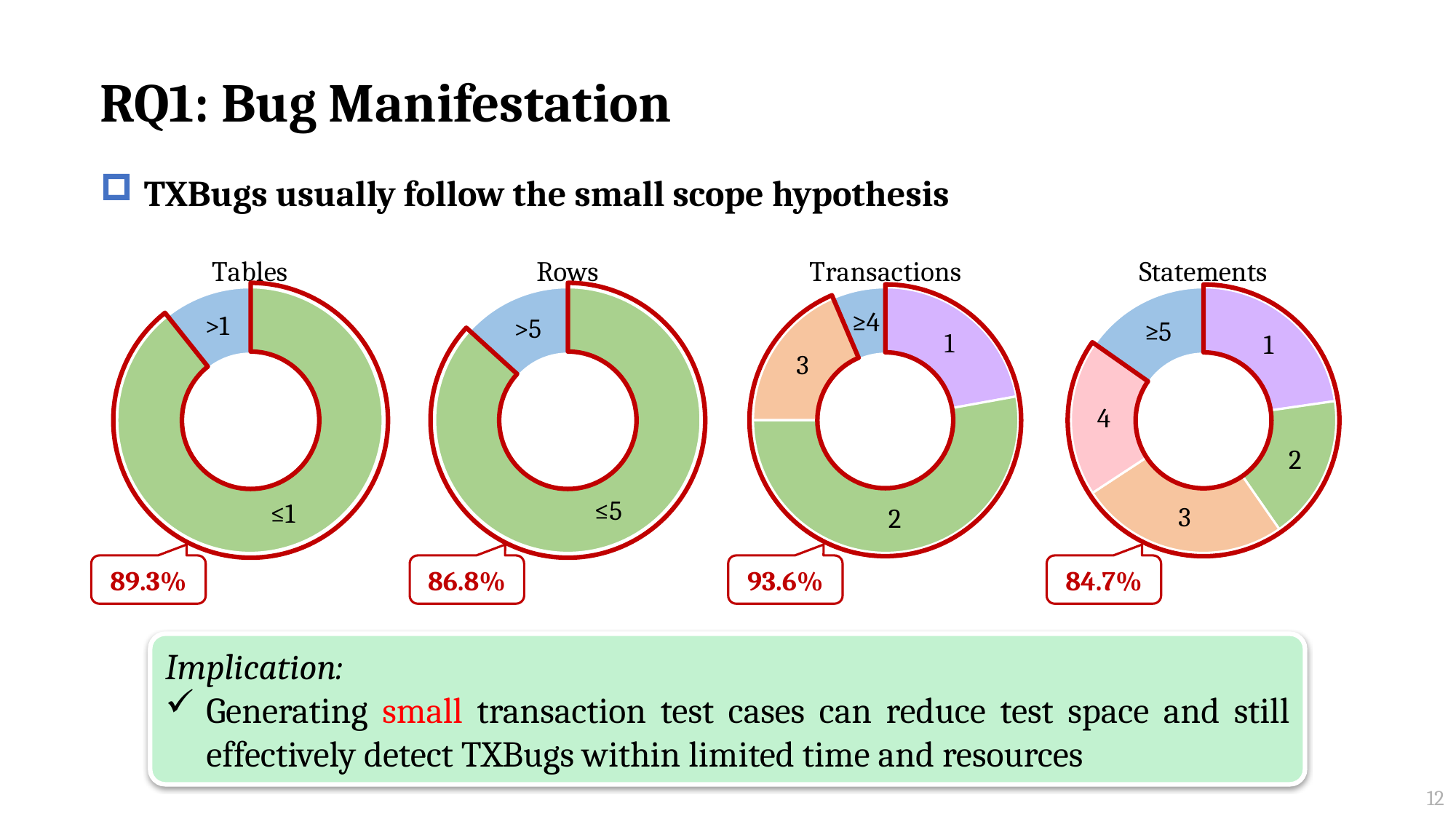
In the "Transactions" chart, which slice is the largest? 2 Which of the four charts has the highest callout percentage? Transactions In the "Tables" chart, which slice is the largest? ≤1 In the "Rows" chart, what percentage is shown in the callout for the ≤5 slice? 86.8% In the "Transactions" chart, what percentage is shown in the callout? 93.6% How many slices does the "Transactions" chart have? 4 In the "Statements" chart, what percentage is shown in the callout? 84.7% In the "Tables" chart, what percentage is shown in the callout for the ≤1 slice? 89.3% In the "Transactions" chart, which slice is larger: 3 or ≥4? 3 What kind of chart is the "Tables" chart? doughnut chart How many slices does the "Statements" chart have? 5 In the "Rows" chart, which slice is the smallest? >5